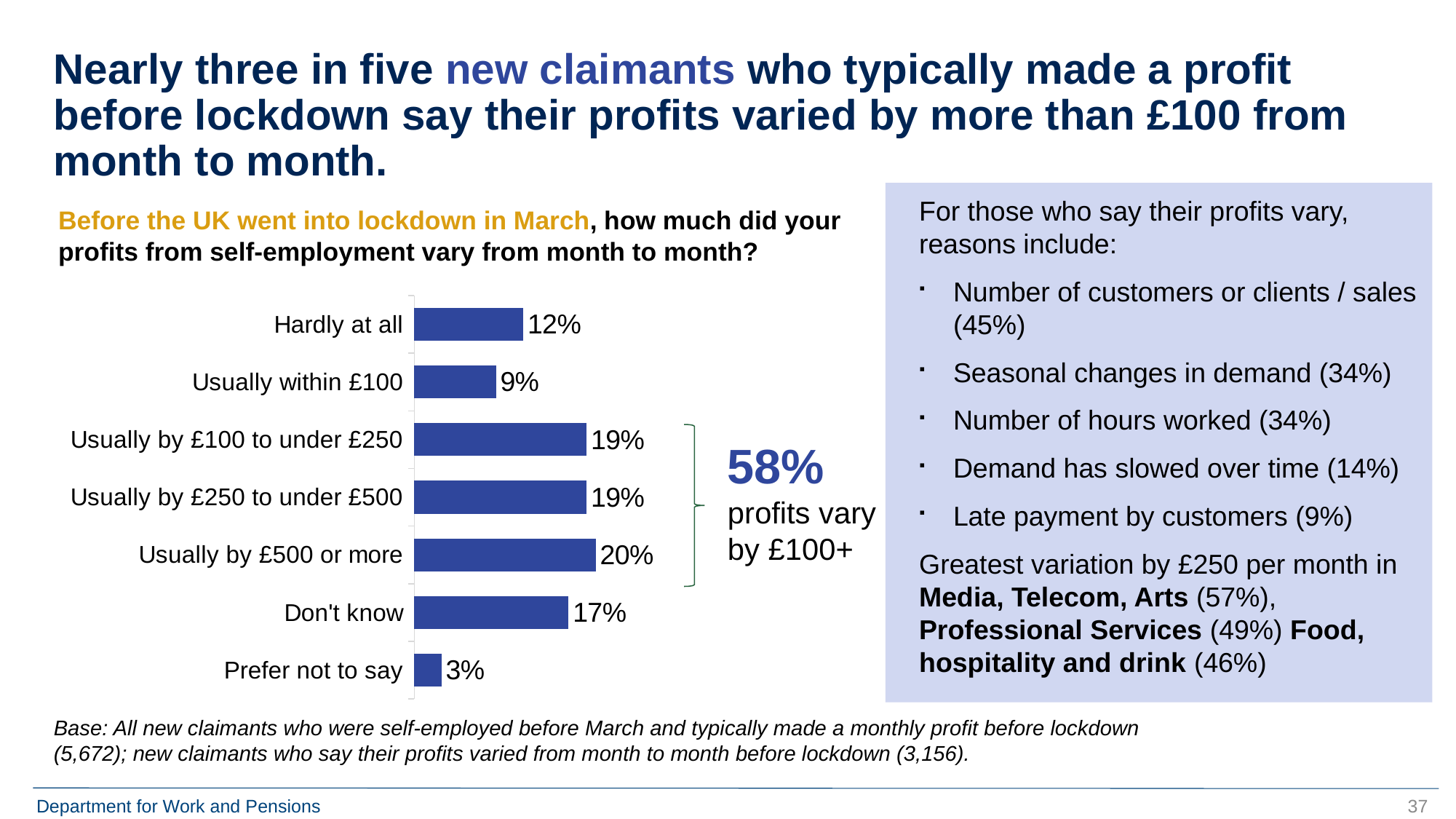
What percentage of respondents said their profits varied 'Hardly at all'? 12% Which category has the highest value in the chart? Usually by £500 or more What percentage is shown next to the bracket grouping the bars for profits varying by £100 or more? 58% Which category has the lowest value in the chart? Prefer not to say Which is larger: 'Don't know' or 'Hardly at all'? Don't know What is the value for 'Usually by £500 or more'? 20% What percentage answered 'Don't know'? 17% How many categories are shown in the bar chart? 7 What is the difference between 'Hardly at all' and 'Usually within £100'? 3% What is the value for 'Usually by £100 to under £250'? 19% What type of chart is shown on the slide? Bar chart What is the combined percentage of the three categories bracketed as 'profits vary by £100+'? 58%